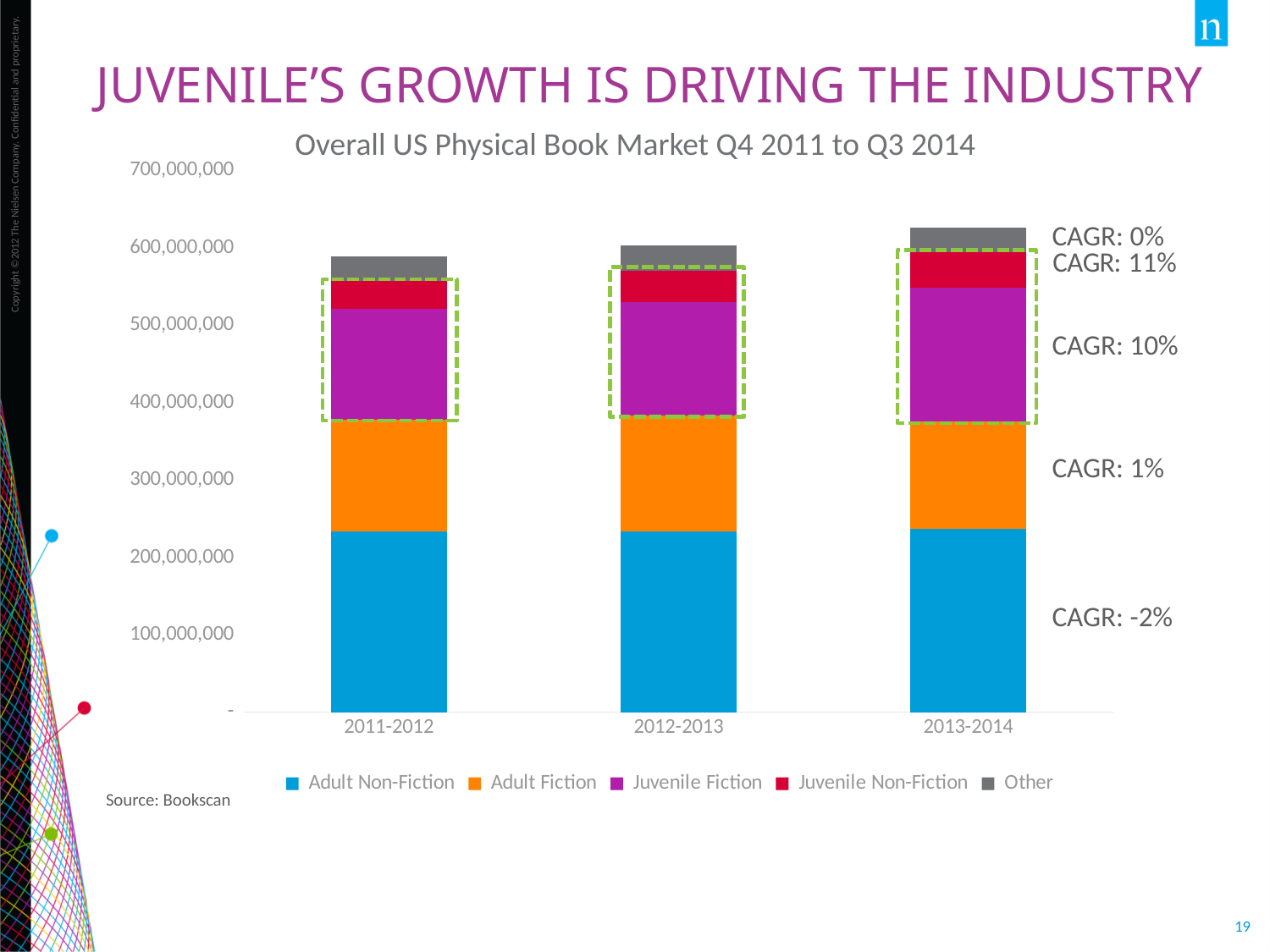
Which period has the tallest total stacked bar? 2013-2014 Is the Adult Non-Fiction segment for 2012-2013 greater or less than 200,000,000? greater Is the total stacked bar for 2011-2012 greater or less than 600,000,000? less What CAGR is shown for Juvenile Fiction? 10% How many series does the chart's legend list? 5 Is the total stacked bar for 2013-2014 greater or less than 600,000,000? greater What type of chart is shown on the slide? Stacked bar chart What CAGR is shown for Adult Non-Fiction? -2% Do the total stacked bars rise or fall from 2011-2012 to 2013-2014? rise How many time periods are shown on the x axis of the chart? 3 What is the title of the chart? Overall US Physical Book Market Q4 2011 to Q3 2014 Which period has the shortest total stacked bar? 2011-2012